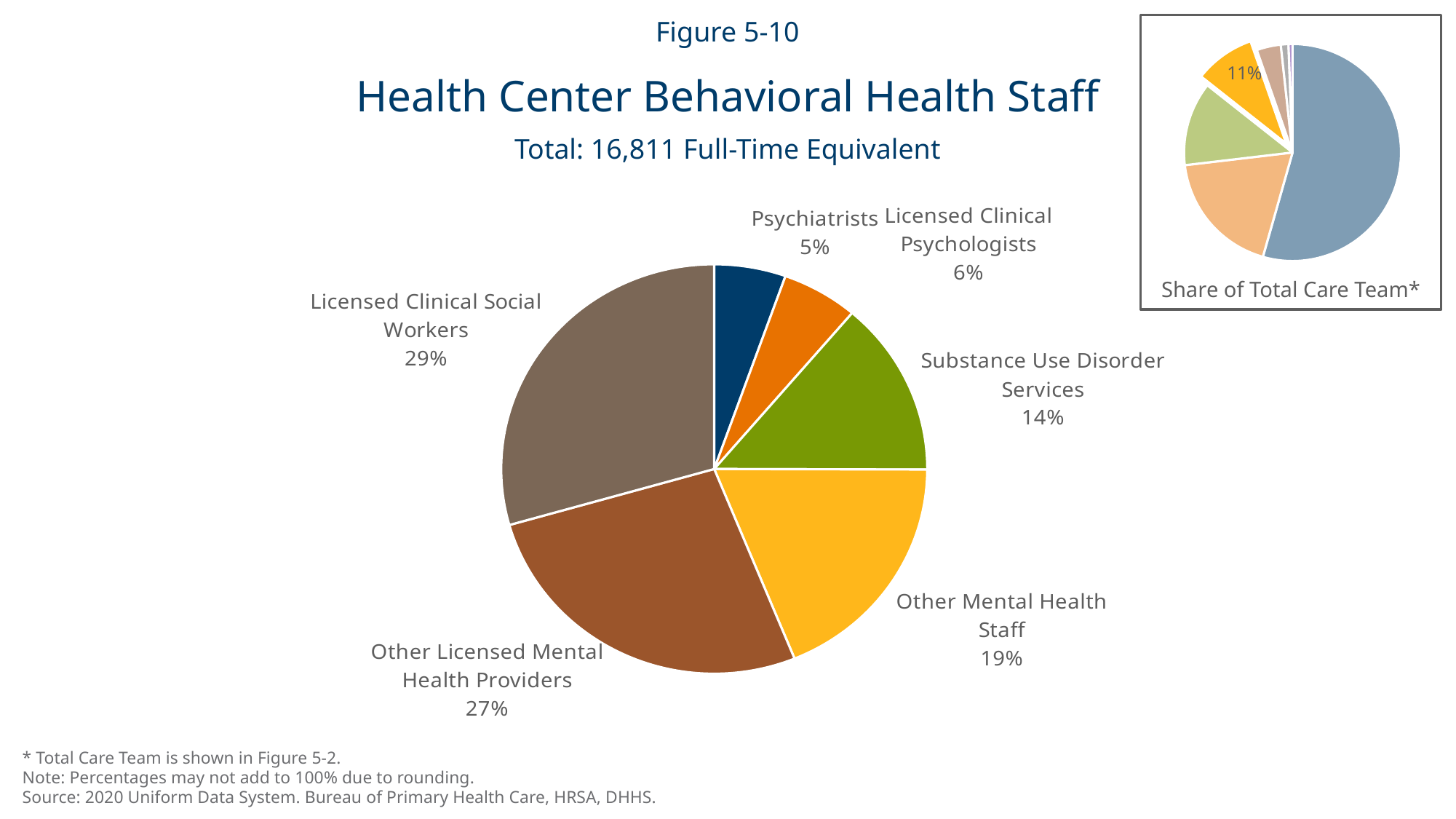
In the main pie chart, which category has the smallest share? Psychiatrists In the main pie chart, which is larger: Licensed Clinical Psychologists or Substance Use Disorder Services? Substance Use Disorder Services In the main pie chart, which category has the largest share? Licensed Clinical Social Workers In the main pie chart, what is the difference in percentage points between Other Licensed Mental Health Providers and Other Mental Health Staff? 8 percentage points What kind of chart is the main chart on the slide? Pie chart In the main pie chart, what percentage is shown for Other Mental Health Staff? 19% In the main pie chart, what share of Health Center Behavioral Health Staff are Licensed Clinical Social Workers? 29% In the main pie chart, what percentage is shown for Psychiatrists? 5% In the main pie chart, what percentage is shown for Substance Use Disorder Services? 14% What total is stated in the subtitle of the main chart? 16,811 Full-Time Equivalent How many categories are shown in the main pie chart? 6 In the small inset chart titled 'Share of Total Care Team*', what percentage is labeled on the highlighted slice? 11%